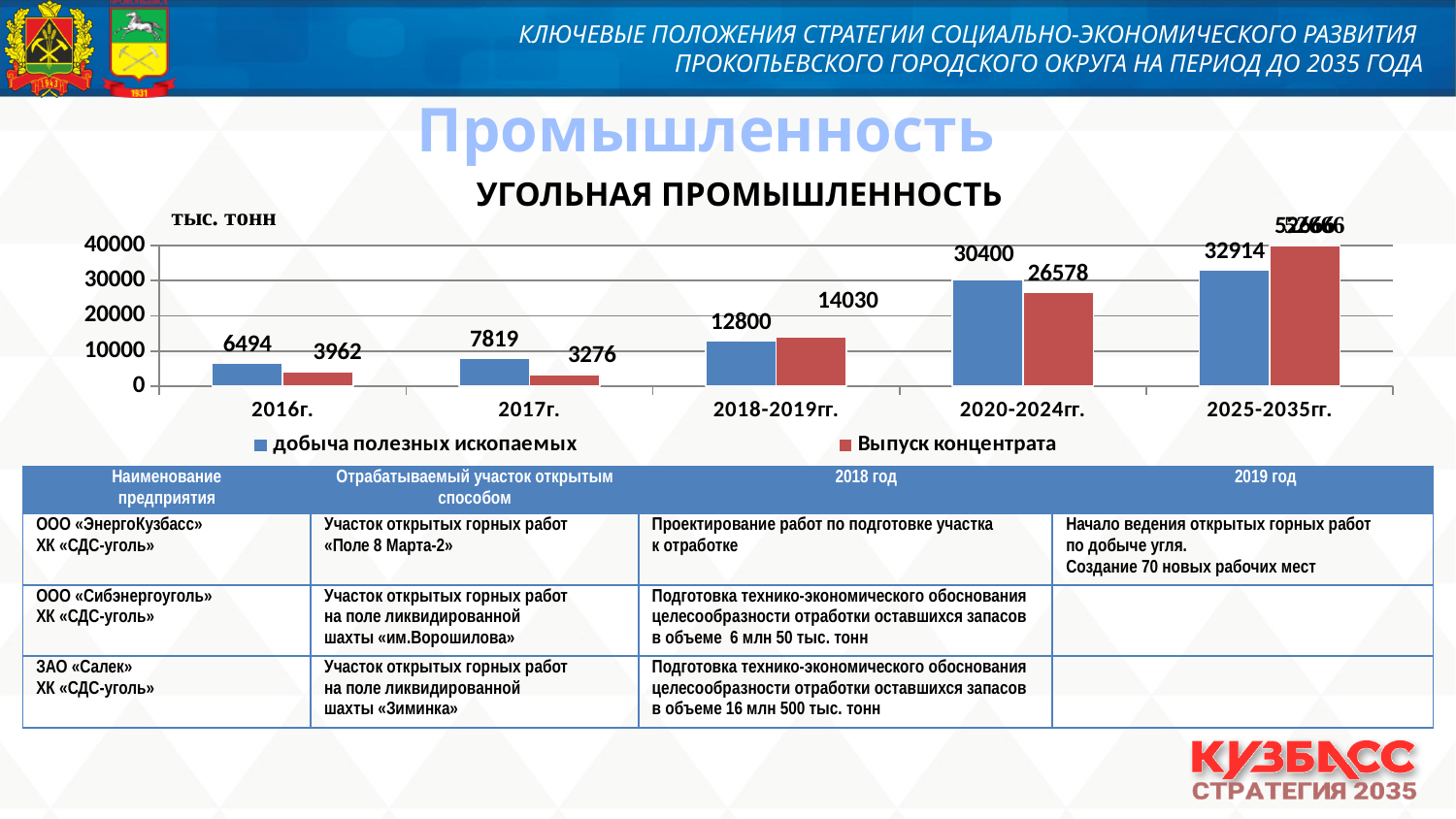
What is the value of «Выпуск концентрата» for 2017г.? 3276 How many series does the legend of the coal industry chart list? 2 What is the value of «добыча полезных ископаемых» for 2016г.? 6494 Which category has the lowest value of «Выпуск концентрата»? 2017г. What is the difference between «добыча полезных ископаемых» and «Выпуск концентрата» in 2020-2024гг.? 3822 What kind of chart is shown under the heading «УГОЛЬНАЯ ПРОМЫШЛЕННОСТЬ»? bar chart In 2018-2019гг., which is larger: «добыча полезных ископаемых» or «Выпуск концентрата»? Выпуск концентрата Is the value of «Выпуск концентрата» for 2025-2035гг. greater or less than 30000? greater How many categories are shown on the x axis of the coal industry chart? 5 What is the value of «Выпуск концентрата» for 2018-2019гг.? 14030 Which category has the highest value of «добыча полезных ископаемых»? 2025-2035гг. What is the value of «добыча полезных ископаемых» for 2020-2024гг.? 30400